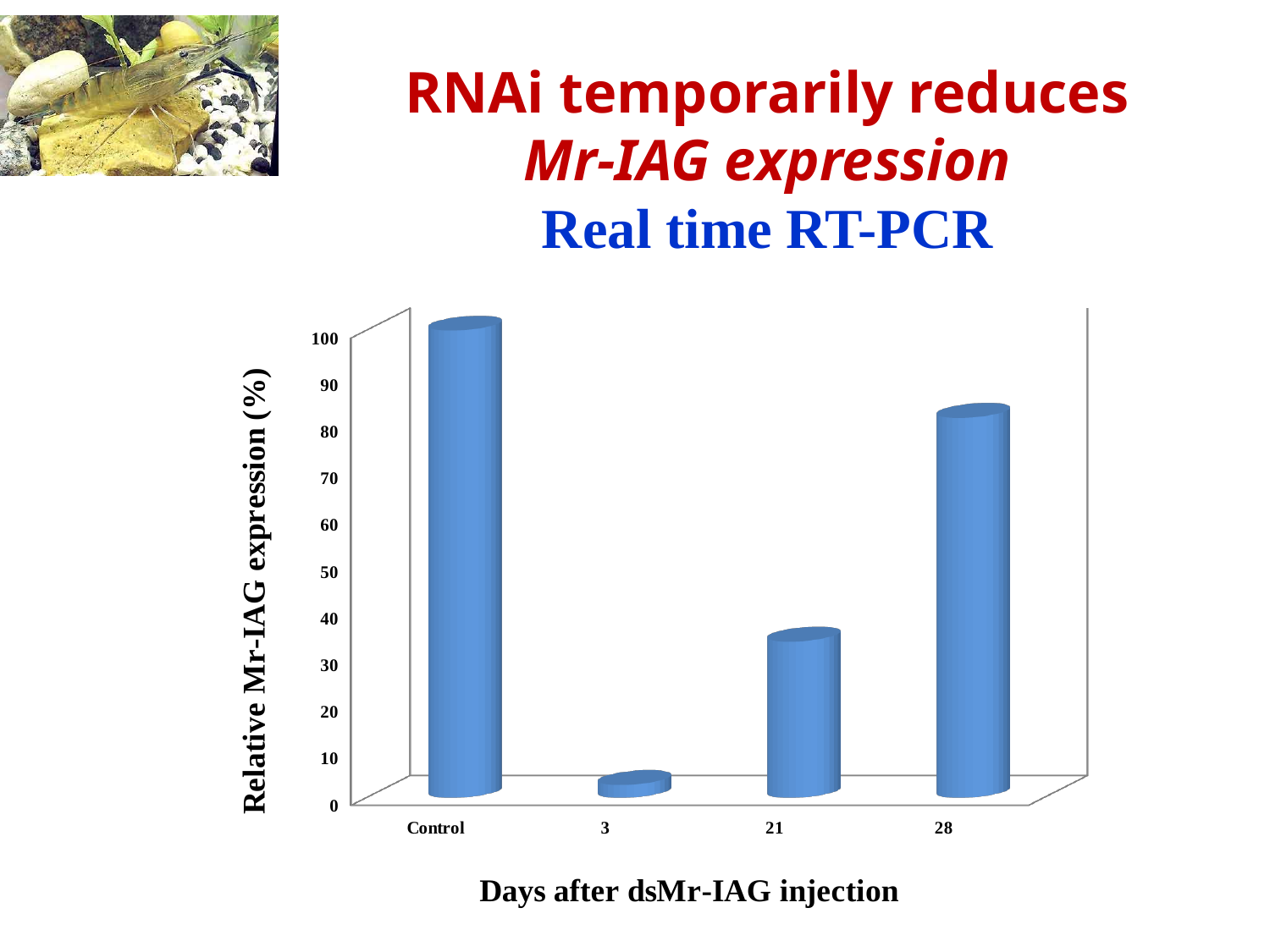
Which has the larger relative Mr-IAG expression, day 21 or day 28? 28 Do the values rise or fall from day 3 to day 28 after injection? rise Is the value for day 21 greater or less than 50? less What is the title of the y axis of the chart? Relative Mr-IAG expression (%) Which category has the lowest relative Mr-IAG expression? 3 Which category has the highest relative Mr-IAG expression? Control Is the value for day 3 greater or less than 10? less What kind of chart is shown on the slide? bar chart Is the value for day 28 greater or less than 70? greater Which has the larger relative Mr-IAG expression, Control or day 21? Control How many categories are shown on the x axis of the chart? 4